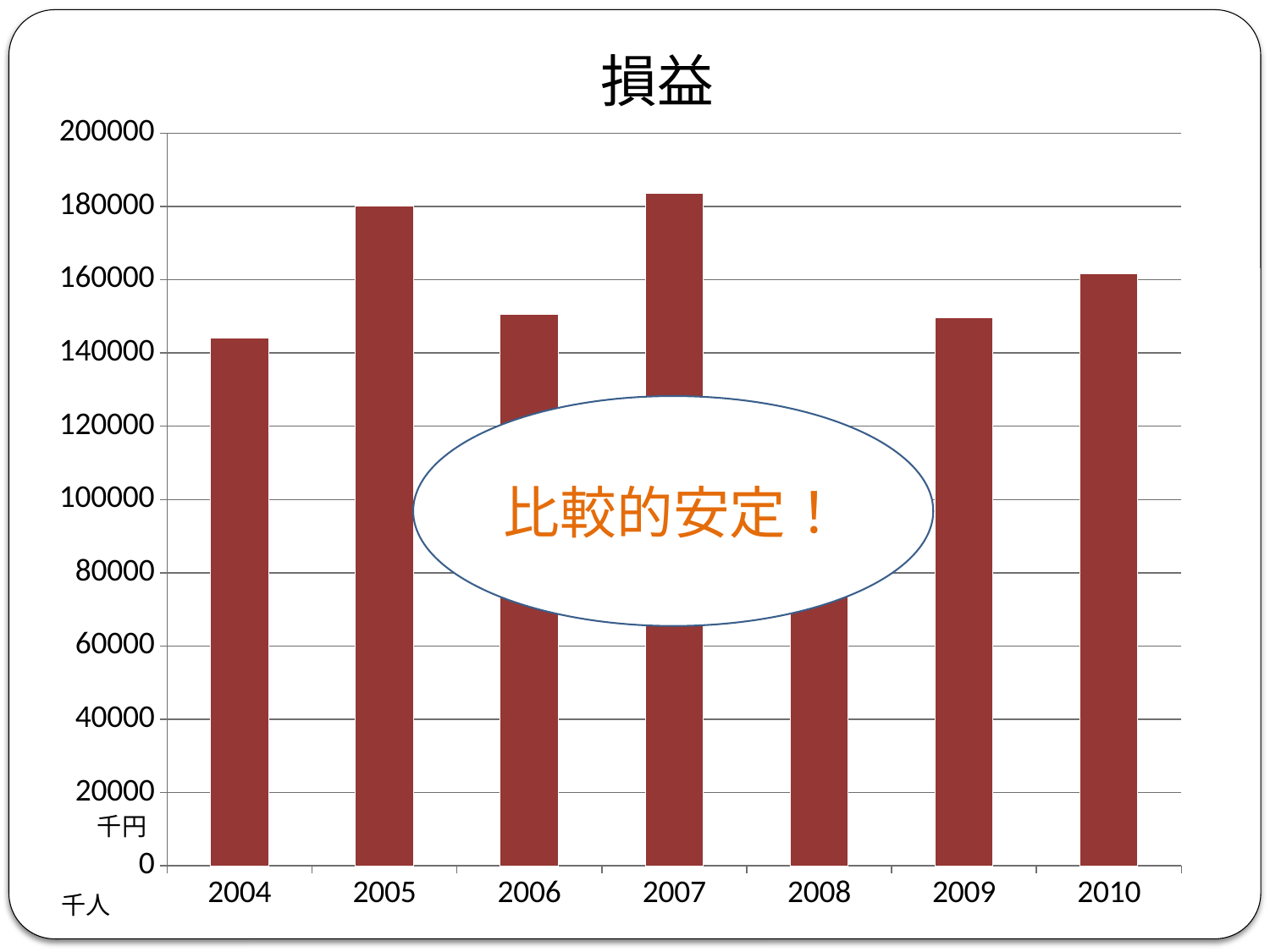
Is the value for 2004 greater or less than 160000? less What text is written inside the oval callout on the chart? 比較的安定！ Is the value for 2006 greater or less than 140000? greater Is the value for 2005 greater or less than 160000? greater What is the title of the chart? 損益 What kind of chart is shown on the slide? bar chart Which is larger, the value for 2010 or the value for 2009? 2010 How many years are shown on the x axis of the chart? 7 Which is larger, the value for 2005 or the value for 2004? 2005